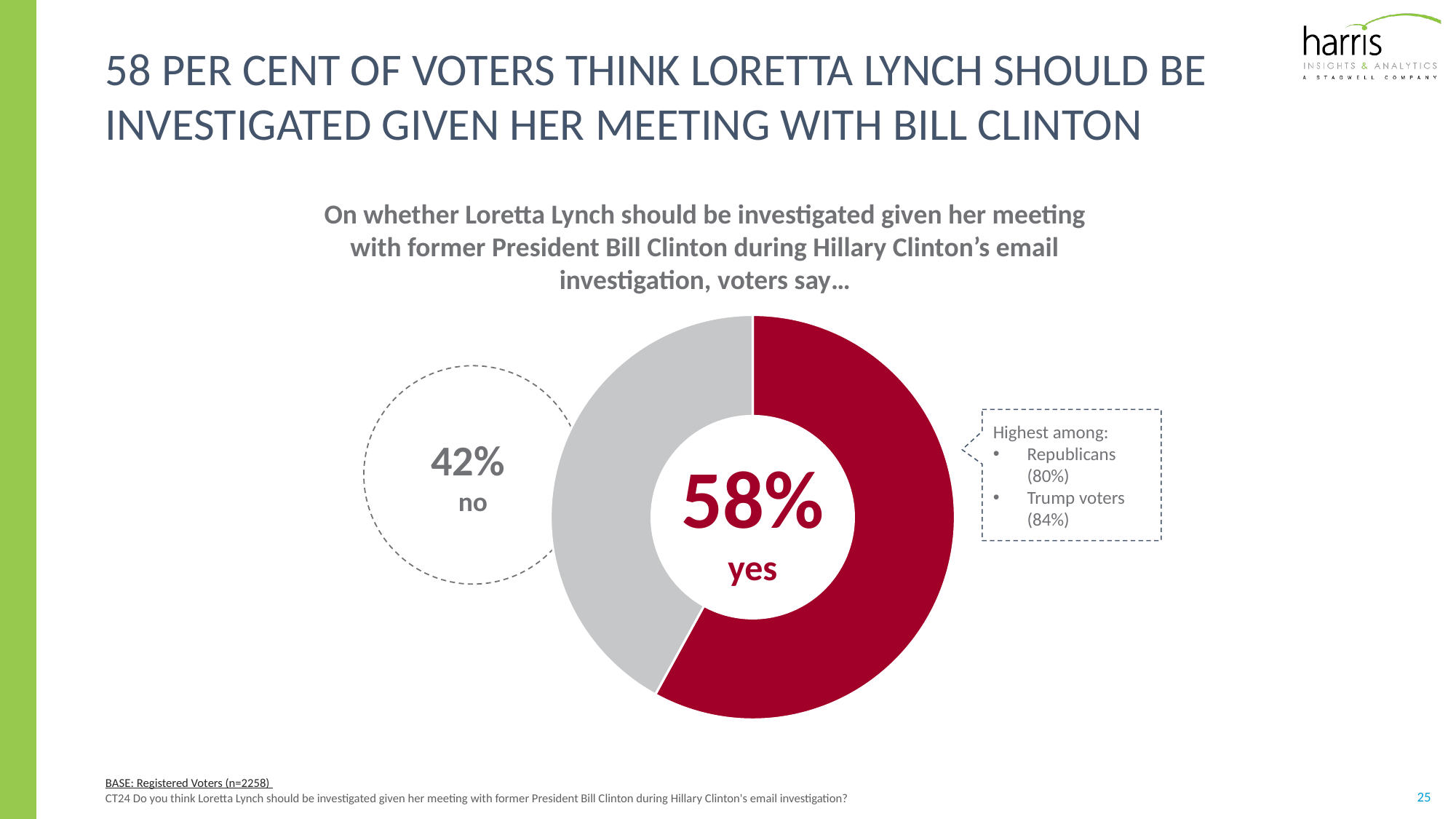
Which response has the larger share of the chart, yes or no? yes What percentage of voters say yes, Loretta Lynch should be investigated? 58% According to the callout, what percentage of Republicans say Lynch should be investigated? 80% According to the callout, what percentage of Trump voters say Lynch should be investigated? 84% What kind of chart is used to show the yes and no responses? pie chart (doughnut) What colour is the yes segment of the chart? red What is the difference in percentage points between the yes and no responses? 16 How many response categories are shown in the chart? 2 What is the total of the yes and no percentages shown in the chart? 100% Is the share of voters saying yes larger or smaller than the share saying no? larger What percentage of voters say no, Loretta Lynch should not be investigated? 42% Which response has the smaller share of the chart, yes or no? no